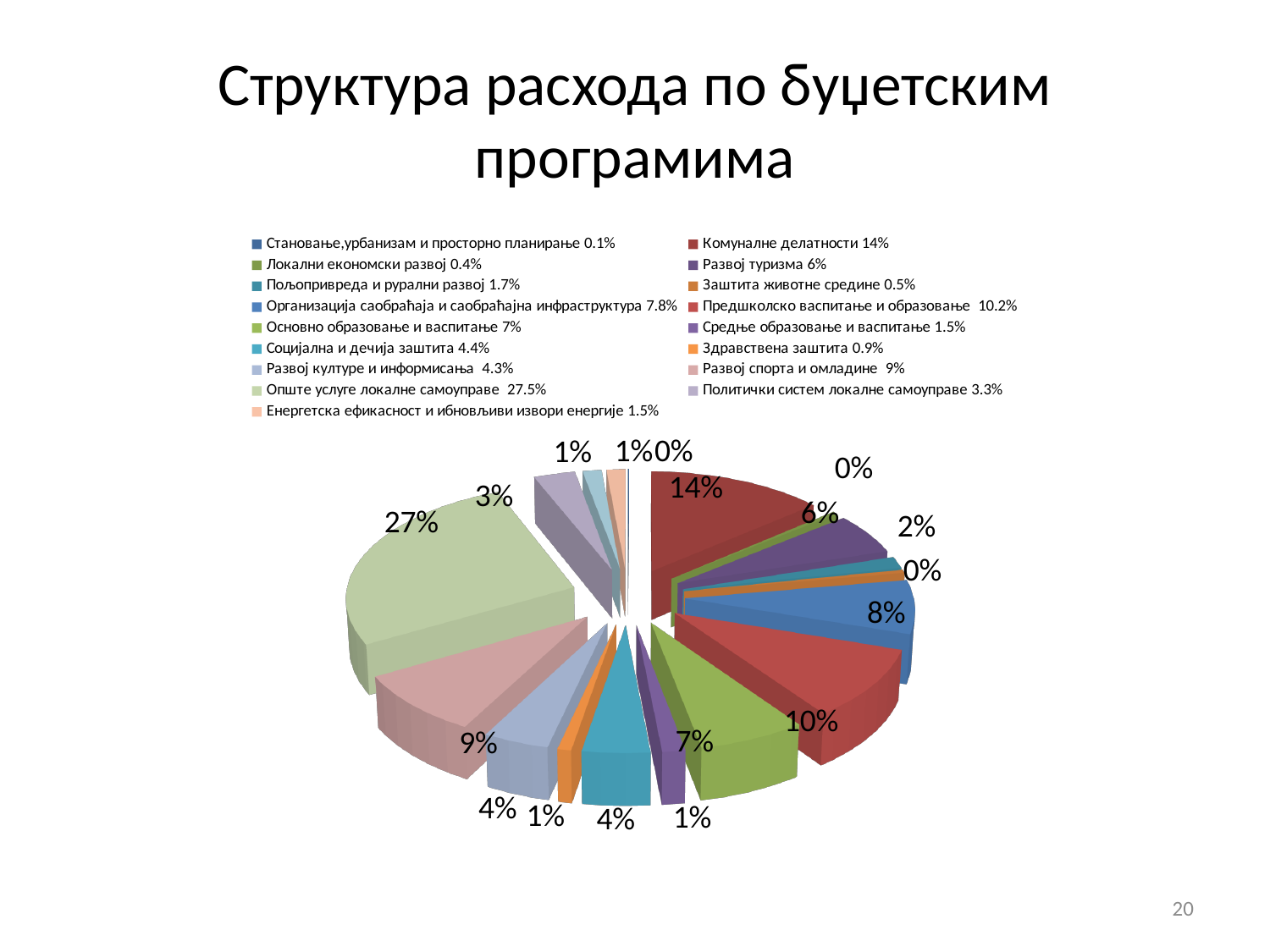
Which budget programme has the smallest share of expenditure according to the legend? Становање,урбанизам и просторно планирање What percentage is listed in the legend for Организација саобраћаја и саобраћајна инфраструктура? 7.8% What kind of chart is shown on the slide? pie chart Using the legend values, what is the difference between the share of Опште услуге локалне самоуправе and the share of Комуналне делатности? 13.5% What is the title of the slide? Структура расхода по буџетским програмима What data label is printed on the largest slice of the pie? 27% How many budget programmes are listed in the legend? 17 Which budget programme has the largest share of expenditure according to the legend? Опште услуге локалне самоуправе Which has a larger share: Развој туризма or Основно образовање и васпитање? Основно образовање и васпитање Which has a larger share: Развој спорта и омладине or Организација саобраћаја и саобраћајна инфраструктура? Развој спорта и омладине What percentage is listed in the legend for Комуналне делатности? 14% What percentage is listed in the legend for Предшколско васпитање и образовање? 10.2%